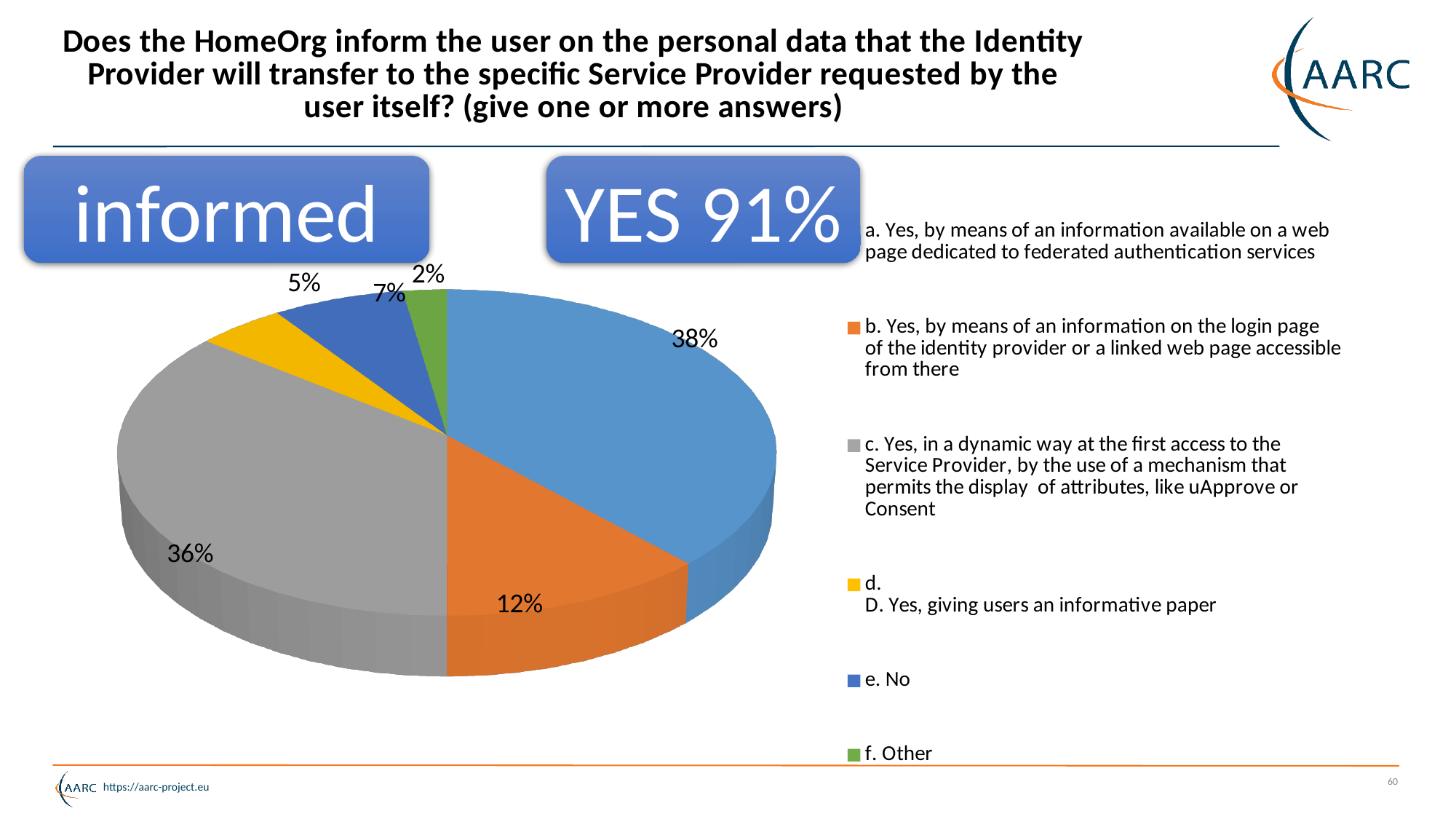
How many slices does the pie chart have? 6 What percentage of the pie is the slice for "c. Yes, in a dynamic way at the first access to the Service Provider, by the use of a mechanism that permits the display of attributes, like uApprove or Consent"? 36% Which answer option has the smallest slice of the pie? f. Other What percentage of the pie is the slice for "d. Yes, giving users an informative paper"? 5% Which slice is larger: "b. Yes, by means of an information on the login page..." or "e. No"? b. Yes, by means of an information on the login page of the identity provider or a linked web page accessible from there What kind of chart is shown on the slide? pie chart By how many percentage points does the largest slice (38%) exceed the 36% slice? 2% What percentage of the pie is the slice for "b. Yes, by means of an information on the login page of the identity provider or a linked web page accessible from there"? 12% What percentage of the pie is the slice for "f. Other"? 2% Which answer option has the largest slice of the pie? a. Yes, by means of an information available on a web page dedicated to federated authentication services What percentage of the pie is the slice for "e. No"? 7% What colour is the slice for "d. Yes, giving users an informative paper"? yellow